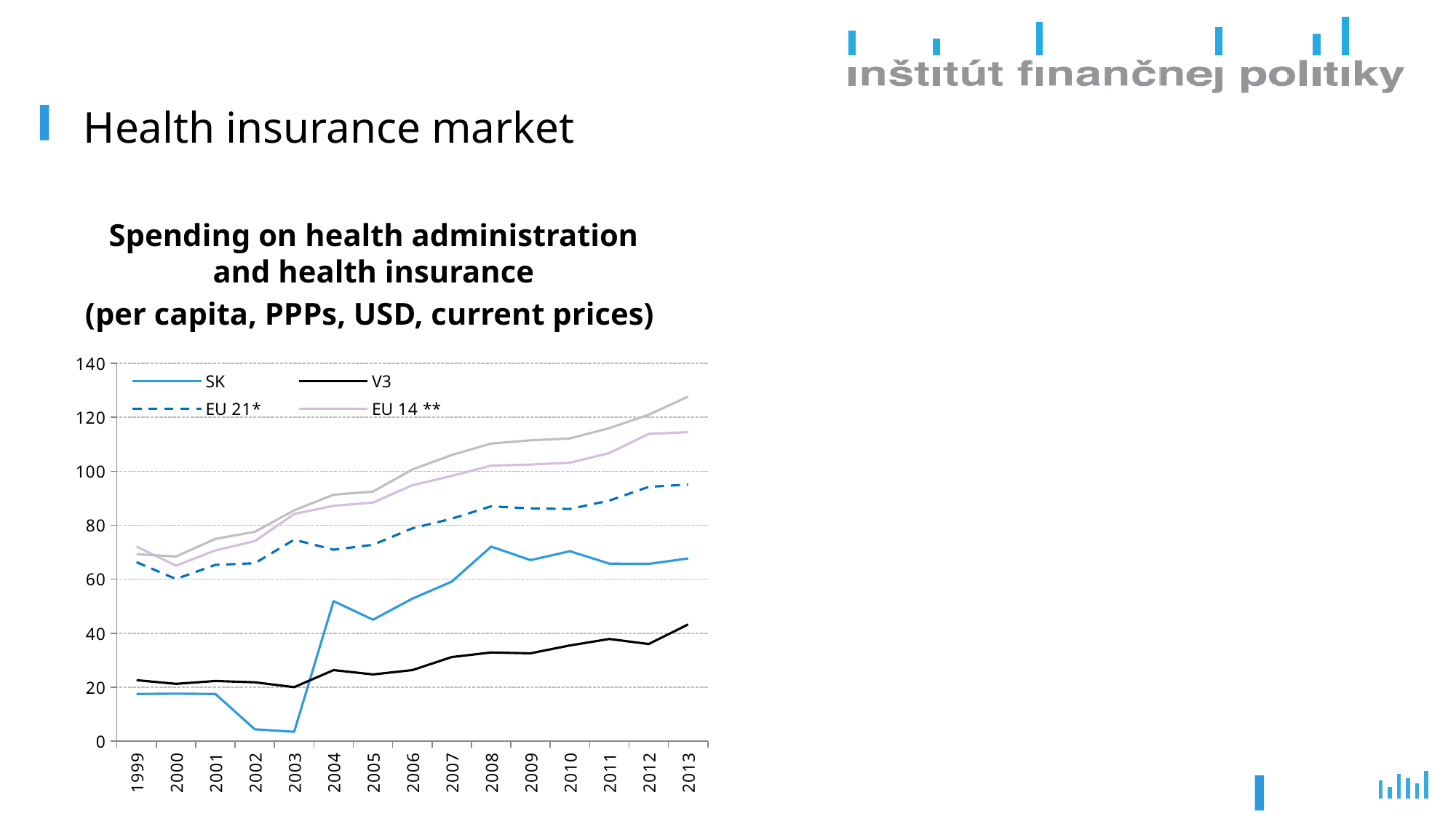
Which series in the legend has the lowest value in 2003? SK How many series does the chart legend list? 4 Is the value for EU 21* in 2013 greater or less than 100? less In 2013, which is larger, the value for SK or the value for V3? SK Does the V3 line generally rise or fall from 1999 to 2013? rise Is the value for SK in 2003 greater or less than 20? less Is the value for EU 14 ** in 2013 greater or less than 100? greater How many years are shown on the x axis of the chart? 15 In 2010, which is larger, the value for EU 14 ** or the value for EU 21*? EU 14 ** What kind of chart is shown on the slide? line chart